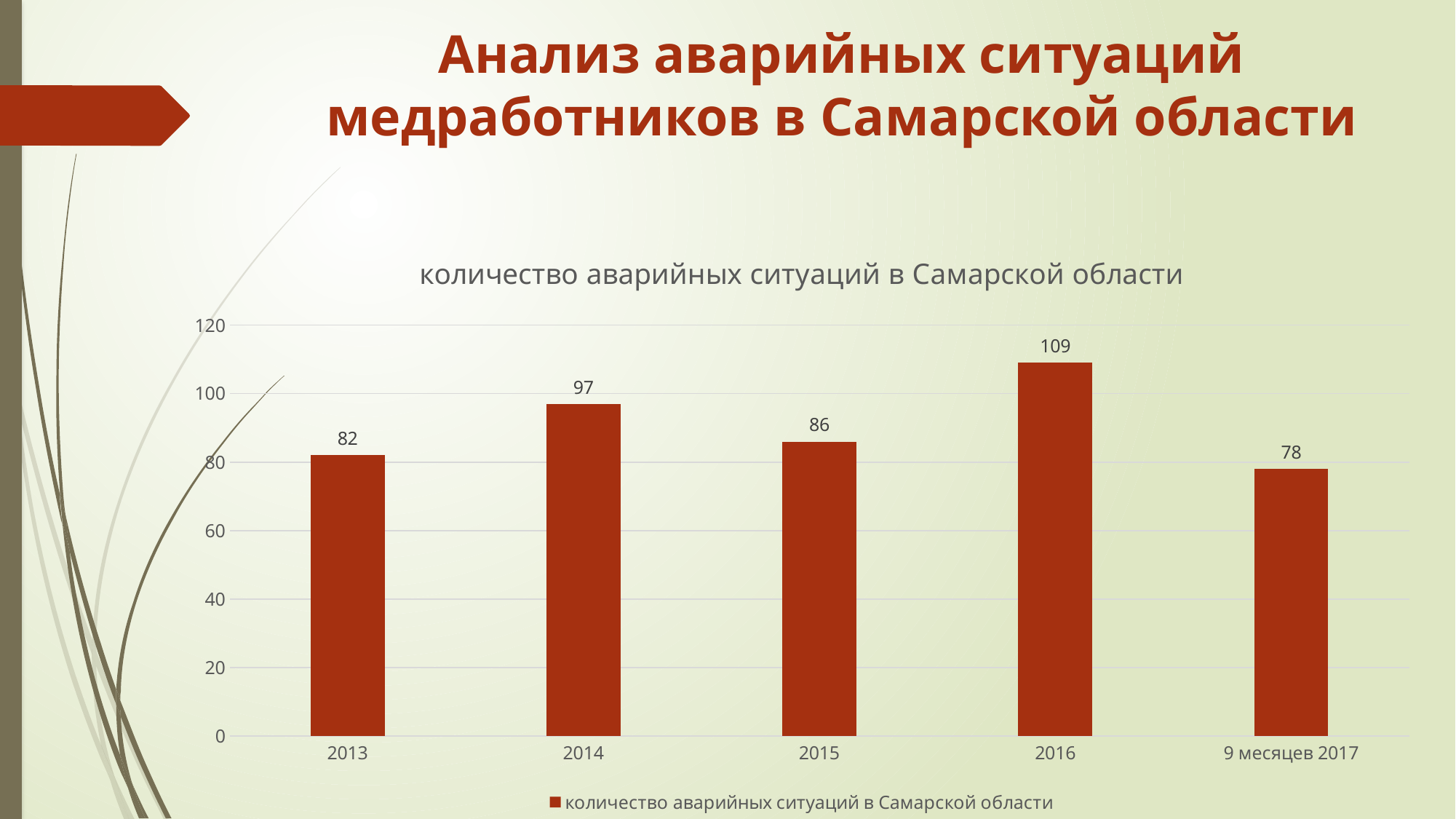
What kind of chart is shown? bar chart What is the title of the chart? количество аварийных ситуаций в Самарской области Which category has the highest value? 2016 Is the value for 2014 greater or less than 100? less What is the value for 2016? 109 How many categories are shown on the x axis? 5 What is the difference between the values for 2016 and 2015? 23 How many series does the legend list? 1 Which is larger, the value for 2014 or the value for 2015? 2014 What is the value for 2013? 82 What is the value for 9 месяцев 2017? 78 Which category has the lowest value? 9 месяцев 2017